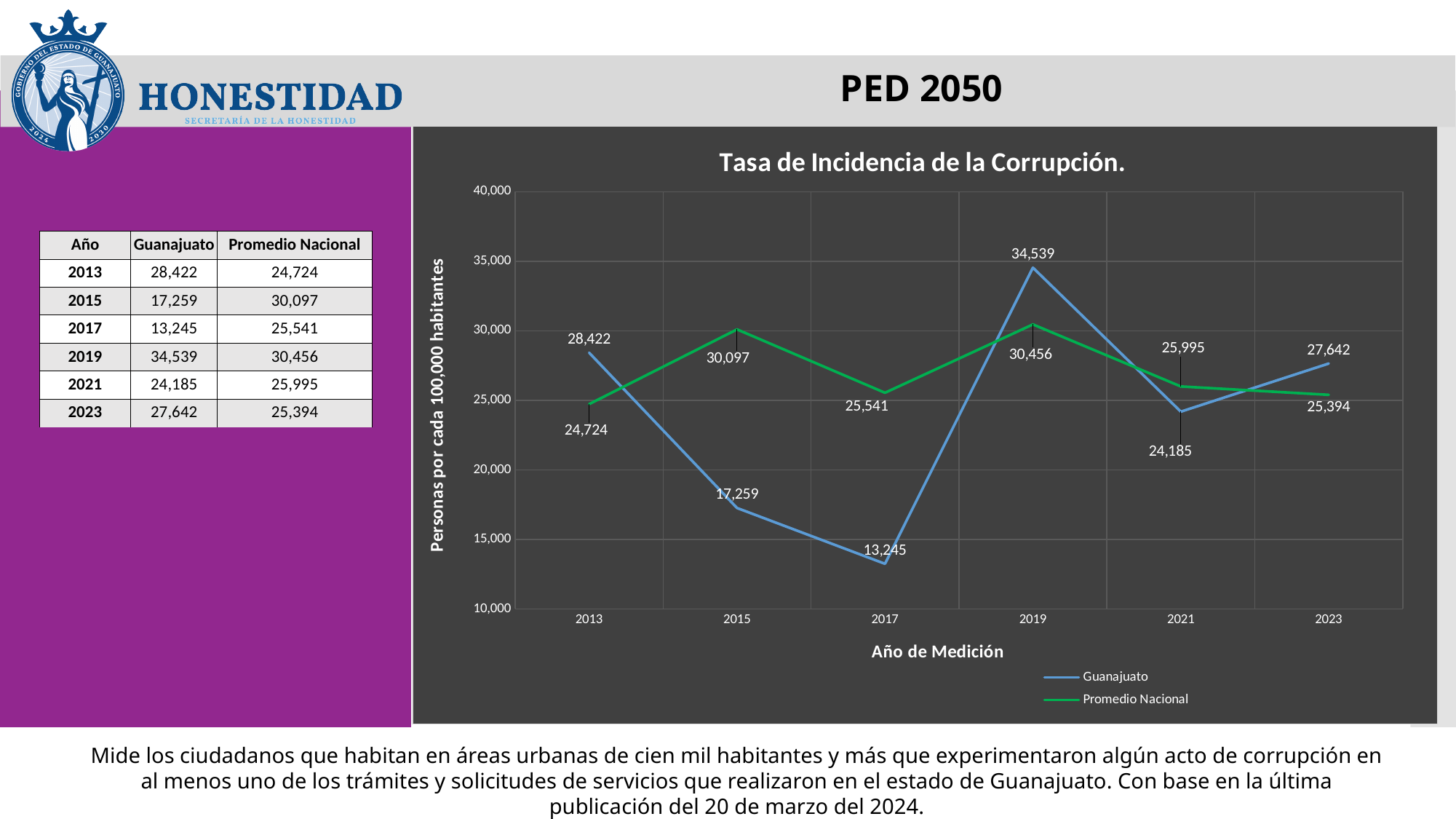
What kind of chart is shown? line chart What is the value for Guanajuato in 2017? 13,245 In which year is the Guanajuato value highest? 2019 How many years are plotted on the x axis? 6 Which is larger in 2021, Guanajuato or Promedio Nacional? Promedio Nacional Is the Guanajuato value for 2015 greater or less than 20,000? less What is the value for Promedio Nacional in 2015? 30,097 What is the difference between the Guanajuato and Promedio Nacional values in 2017? 12,296 In which year is the Guanajuato value lowest? 2017 How many series does the legend list? 2 In which year is the Promedio Nacional value lowest? 2013 What is the value for Guanajuato in 2019? 34,539